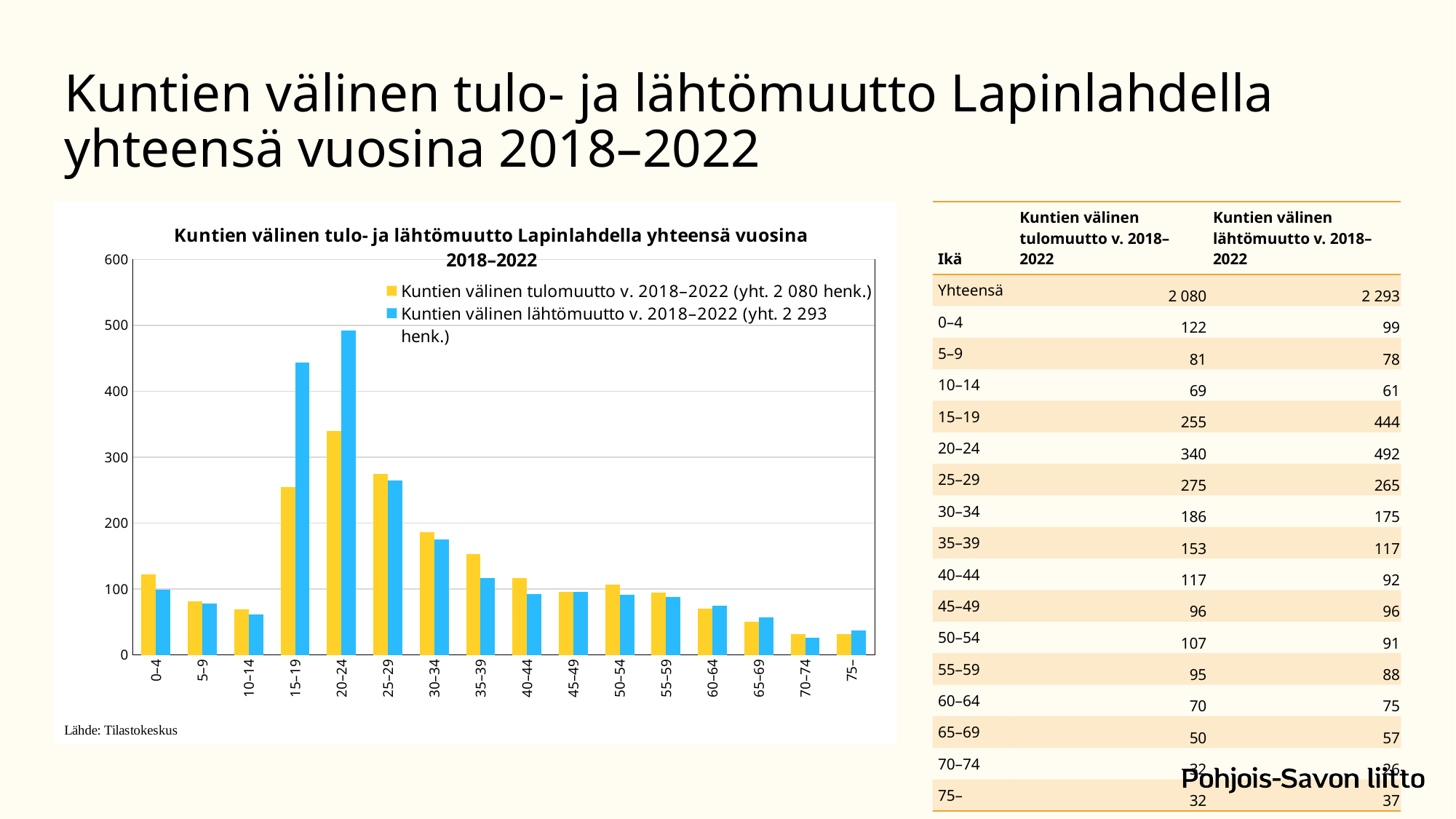
What is the difference between lähtömuutto and tulomuutto for the 20–24 age group? 152 For the 35–39 age group, which is larger: tulomuutto or lähtömuutto? tulomuutto Which age group has the highest value for Kuntien välinen lähtömuutto v. 2018–2022? 20–24 What total number of persons does the legend give for Kuntien välinen lähtömuutto v. 2018–2022? 2 293 What is the value of Kuntien välinen tulomuutto v. 2018–2022 for the 0–4 age group? 122 What is the value of Kuntien välinen lähtömuutto v. 2018–2022 for the 15–19 age group? 444 How many age groups are shown on the x axis of the chart? 16 Is the value of Kuntien välinen lähtömuutto v. 2018–2022 for the 15–19 age group greater or less than 400? greater How many series does the chart legend list? 2 Do the values for Kuntien välinen tulomuutto v. 2018–2022 rise or fall along the x axis from the 25–29 age group to the 75– age group? fall What type of chart is shown on the slide? bar chart Which age group has the highest value for Kuntien välinen tulomuutto v. 2018–2022? 20–24